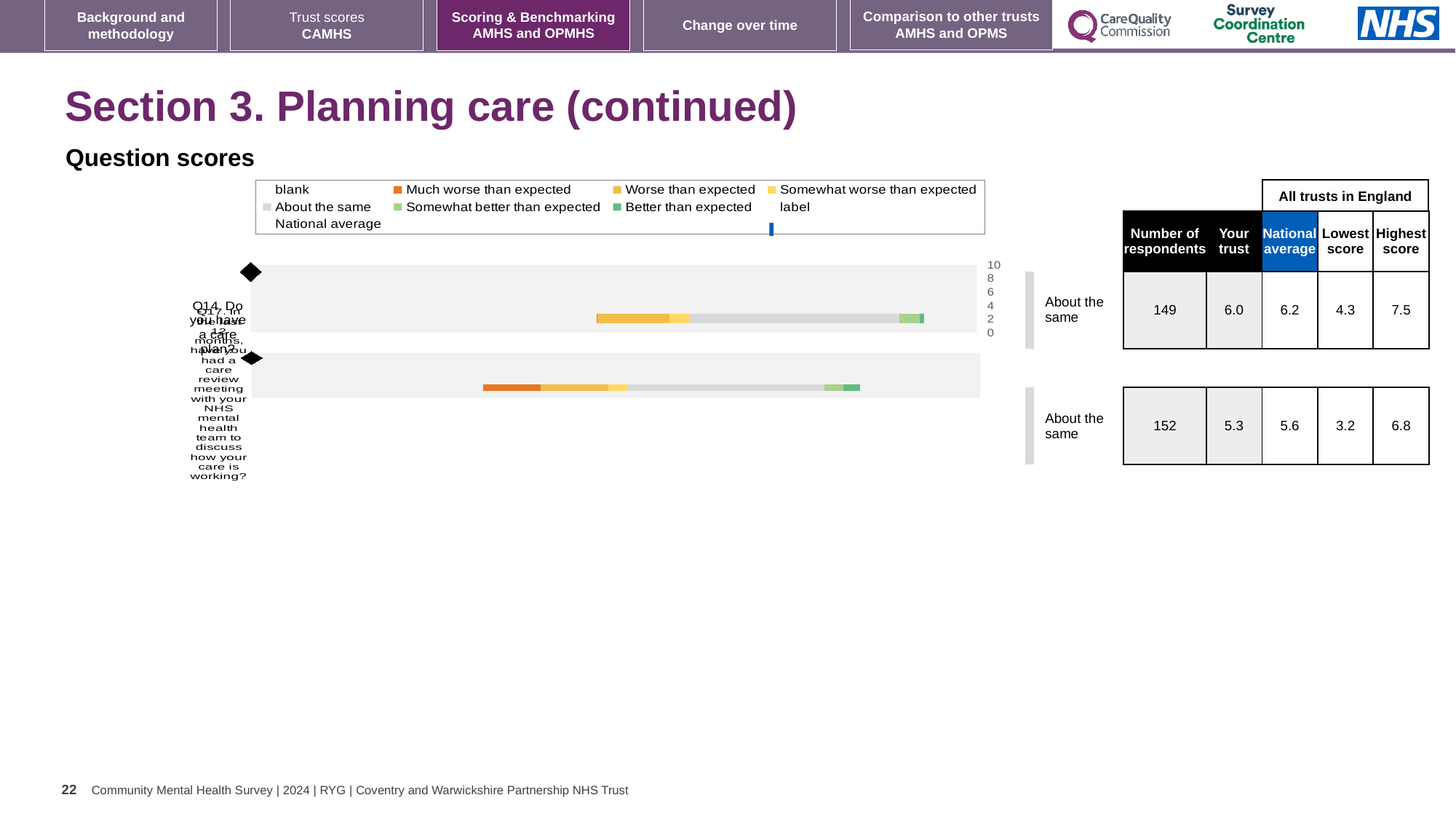
What benchmark category label is shown next to the bar for Q17 (care review meeting)? About the same What kind of chart is shown on the slide? bar chart What benchmark category label is shown next to the bar for Q14 (Do you have a care plan?)? About the same How many questions (bars) are plotted in the chart? 2 Which legend entry is shown in orange? Much worse than expected Which legend entry is shown in dark green? Better than expected